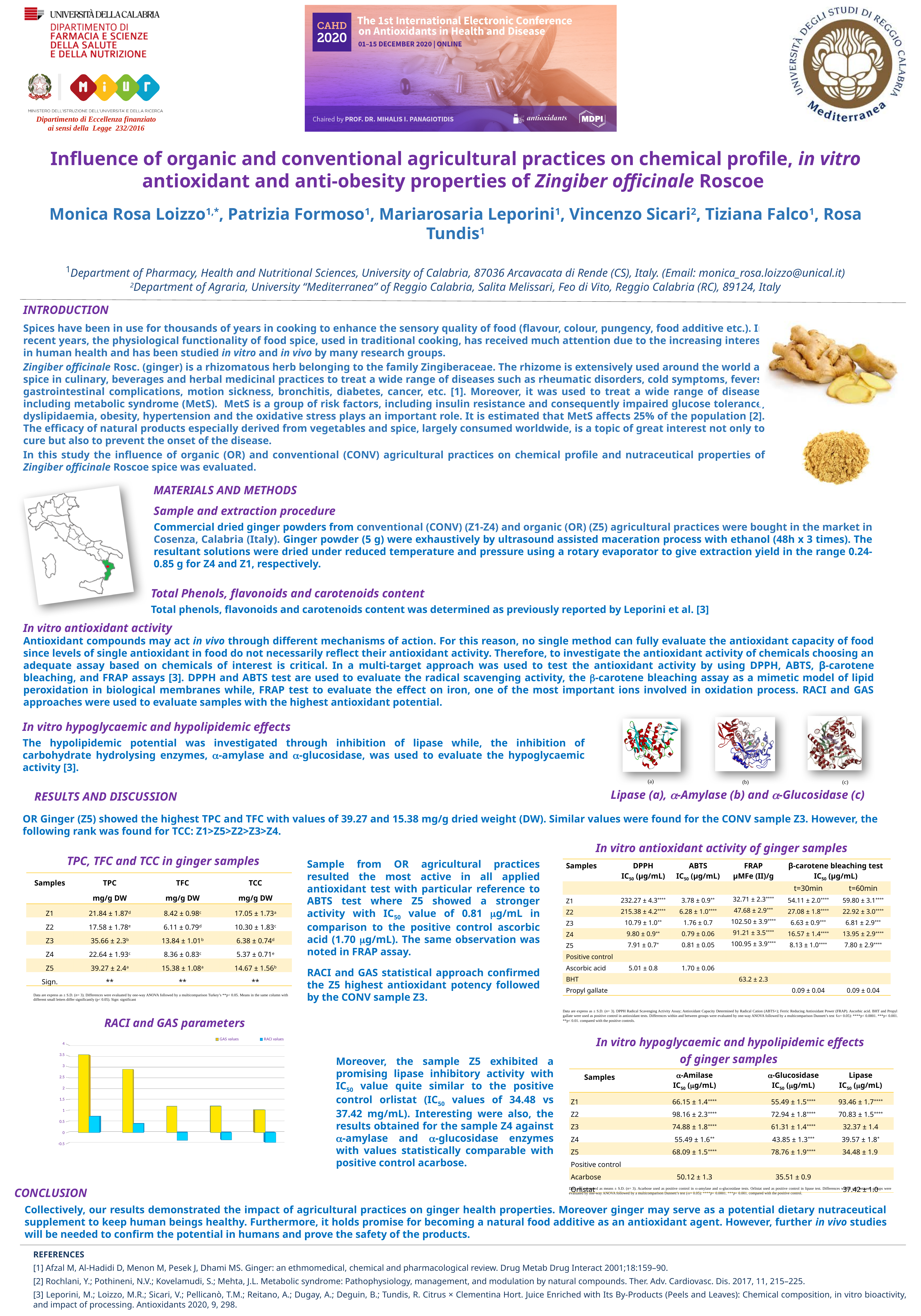
In the 'RACI and GAS parameters' chart, which group of bars has the highest GAS value? the leftmost (first) group In the 'RACI and GAS parameters' chart, is the RACI value of the leftmost group greater or less than 1? less How many groups of bars are plotted in the 'RACI and GAS parameters' chart? 5 How many series does the legend of the 'RACI and GAS parameters' chart list? 2 What kind of chart is the 'RACI and GAS parameters' chart? bar chart In the 'RACI and GAS parameters' chart, is the RACI value of the rightmost group greater or less than 0? less In the 'RACI and GAS parameters' chart, which series is shown in yellow? GAS values In the 'RACI and GAS parameters' chart, for the leftmost group, which is larger: the GAS value or the RACI value? GAS value In the 'RACI and GAS parameters' chart, is the GAS value of the leftmost group greater or less than 3? greater What are the two series named in the legend of the 'RACI and GAS parameters' chart? GAS values and RACI values In the 'RACI and GAS parameters' chart, do the GAS values generally rise or fall from left to right? fall